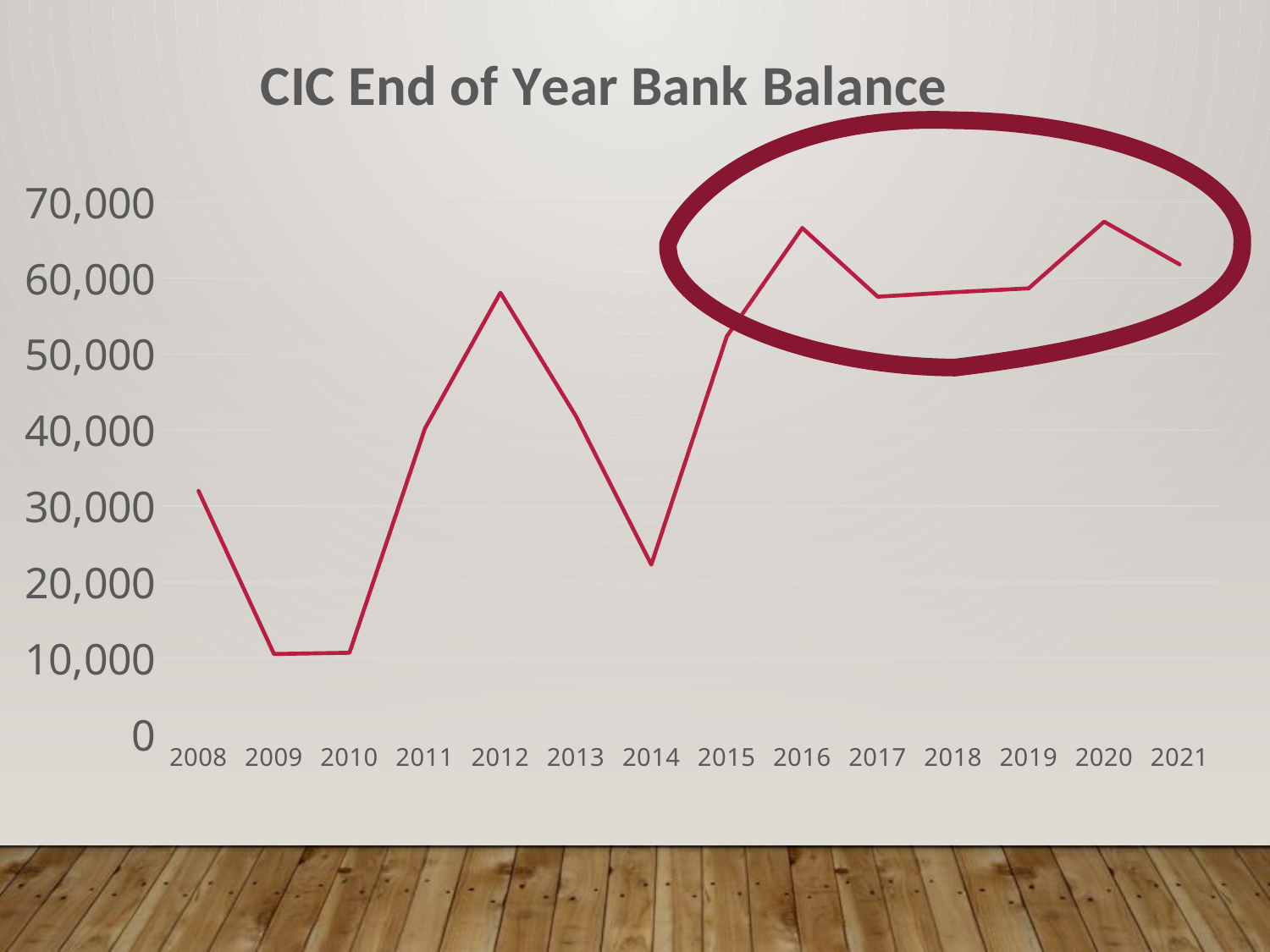
Is the value for 2011 greater or less than 30,000? greater How many years are plotted along the x axis? 14 Is the value for 2014 greater or less than 30,000? less What is the title of the chart? CIC End of Year Bank Balance Does the bank balance rise or fall from 2012 to 2014? fall Is the value for 2016 greater or less than 60,000? greater Which year has the larger bank balance, 2012 or 2014? 2012 Which year has the larger bank balance, 2016 or 2017? 2016 What kind of chart is shown on the slide? line chart Does the bank balance rise or fall from 2014 to 2016? rise